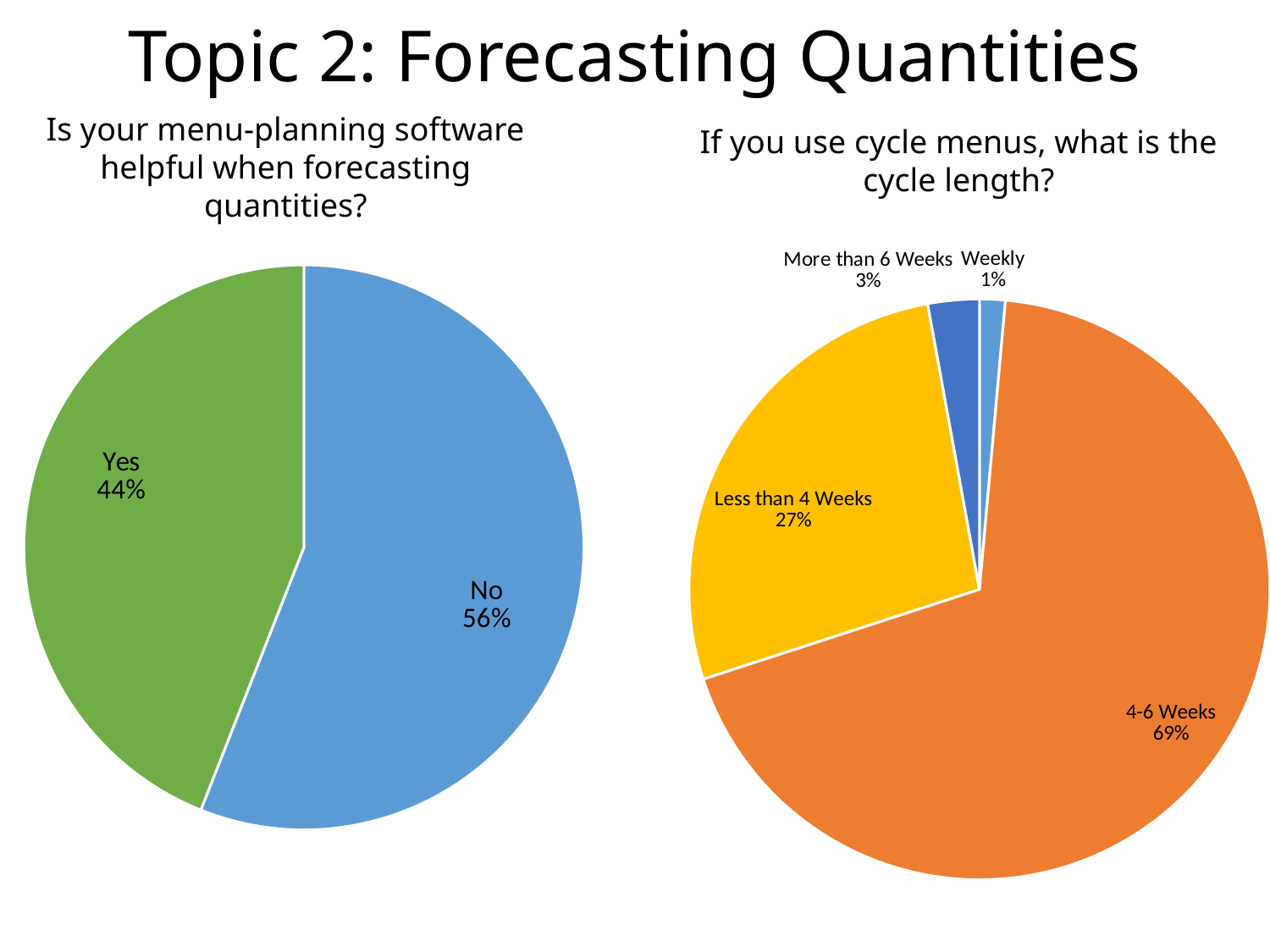
In the left chart (menu-planning software helpful when forecasting quantities), what share of respondents answered No? 56% In the right chart (cycle menu length), which is larger: the share for Less than 4 Weeks or the share for More than 6 Weeks? Less than 4 Weeks In the right chart (cycle menu length), which cycle length has the smallest share? Weekly In the left chart (menu-planning software helpful when forecasting quantities), what share of respondents answered Yes? 44% In the left chart (menu-planning software helpful when forecasting quantities), which response has the larger share? No In the right chart (cycle menu length), what is the difference in percentage points between 4-6 Weeks and Less than 4 Weeks? 42 In the right chart (cycle menu length), what share of respondents chose 4-6 Weeks? 69% In the left chart (menu-planning software helpful when forecasting quantities), what is the difference in percentage points between No and Yes? 12 In the right chart (cycle menu length), how many cycle length categories are shown? 4 In the right chart (cycle menu length), what share of respondents chose Less than 4 Weeks? 27% What kind of chart is the left chart (menu-planning software helpful when forecasting quantities)? Pie chart In the right chart (cycle menu length), what share of respondents chose More than 6 Weeks? 3%